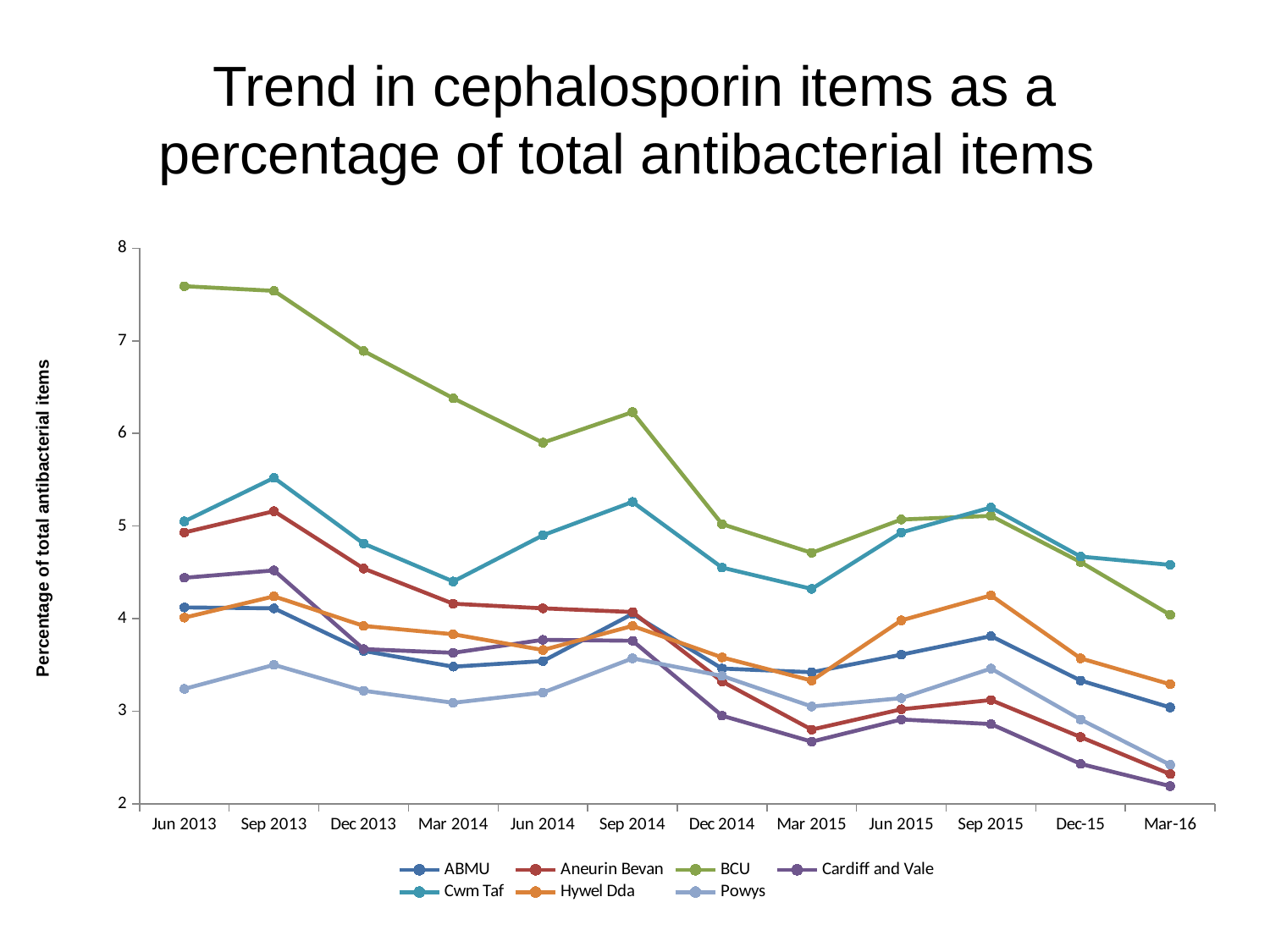
Which series has the highest value at Mar-16? Cwm Taf Which is larger at Sep 2013, the value for Cwm Taf or the value for Hywel Dda? Cwm Taf Does the BCU line generally rise or fall from Jun 2013 to Mar-16? fall Which series has the highest value at Jun 2013? BCU Is the value for BCU at Jun 2013 greater or less than 7? greater Is the value for Cardiff and Vale at Mar 2015 greater or less than 3? less Is the value for Cwm Taf at Mar-16 greater or less than 4? greater What kind of chart is shown on the slide? line chart How many series does the legend list? 7 How many time points are shown along the x axis? 12 What is the label on the vertical axis of the chart? Percentage of total antibacterial items Which series has the lowest value at Jun 2013? Powys